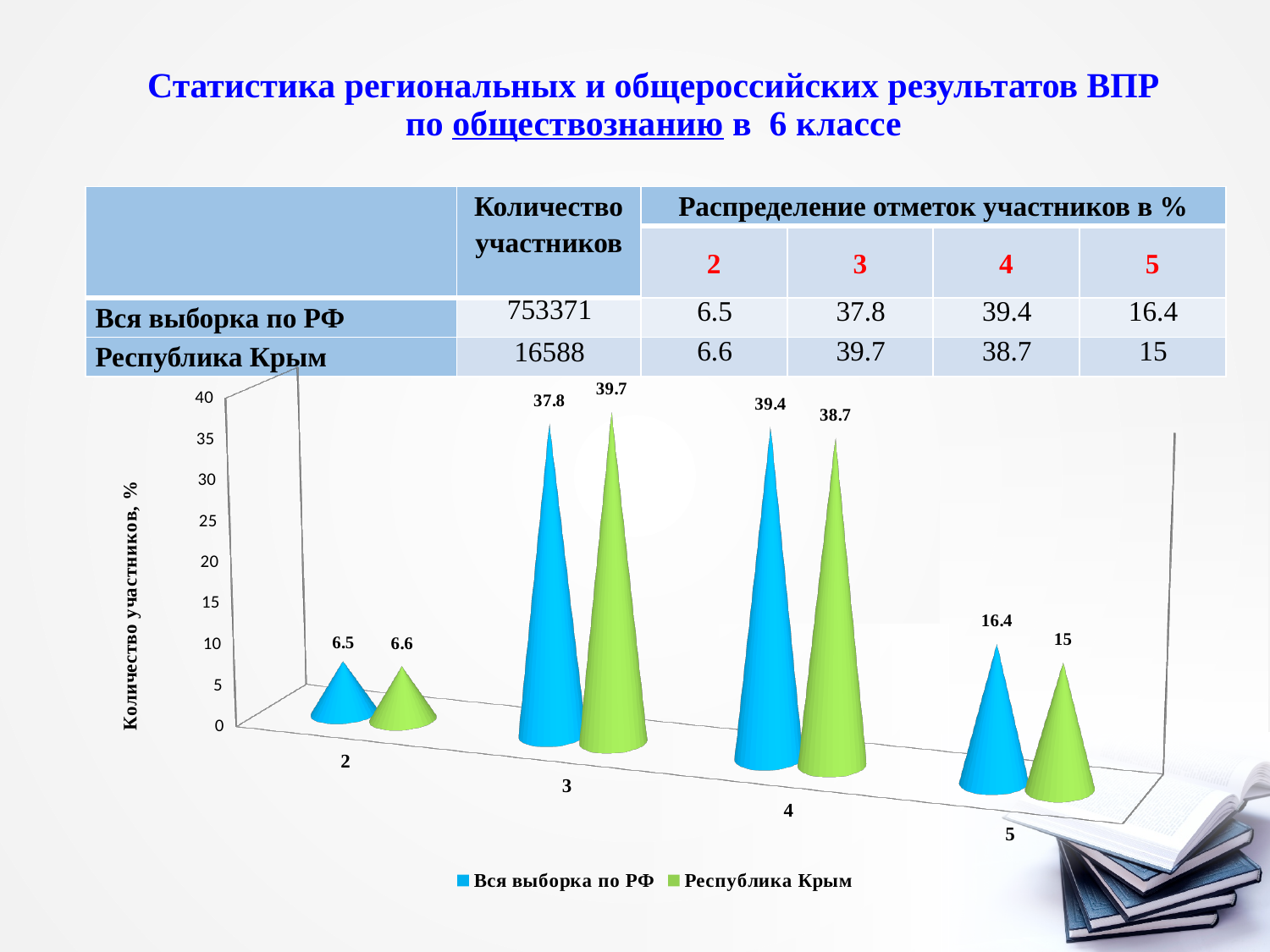
What is the difference between the "Республика Крым" and "Вся выборка по РФ" values at grade 3? 1.9 Which grade category has the lowest value for "Республика Крым"? 2 What is the value for "Республика Крым" at grade 3 in the chart? 39.7 What is the label of the vertical axis of the chart? Количество участников, % How many series does the chart legend list? 2 What is the value for "Вся выборка по РФ" at grade 5 in the chart? 16.4 Which grade category has the highest value for "Вся выборка по РФ"? 4 How many grade categories are shown on the x axis of the chart? 4 What is the difference between the "Вся выборка по РФ" and "Республика Крым" values at grade 5? 1.4 What is the value for "Вся выборка по РФ" at grade 2 in the chart? 6.5 At grade 4, which series has the larger value: "Вся выборка по РФ" or "Республика Крым"? Вся выборка по РФ What kind of chart is shown on the slide? bar chart